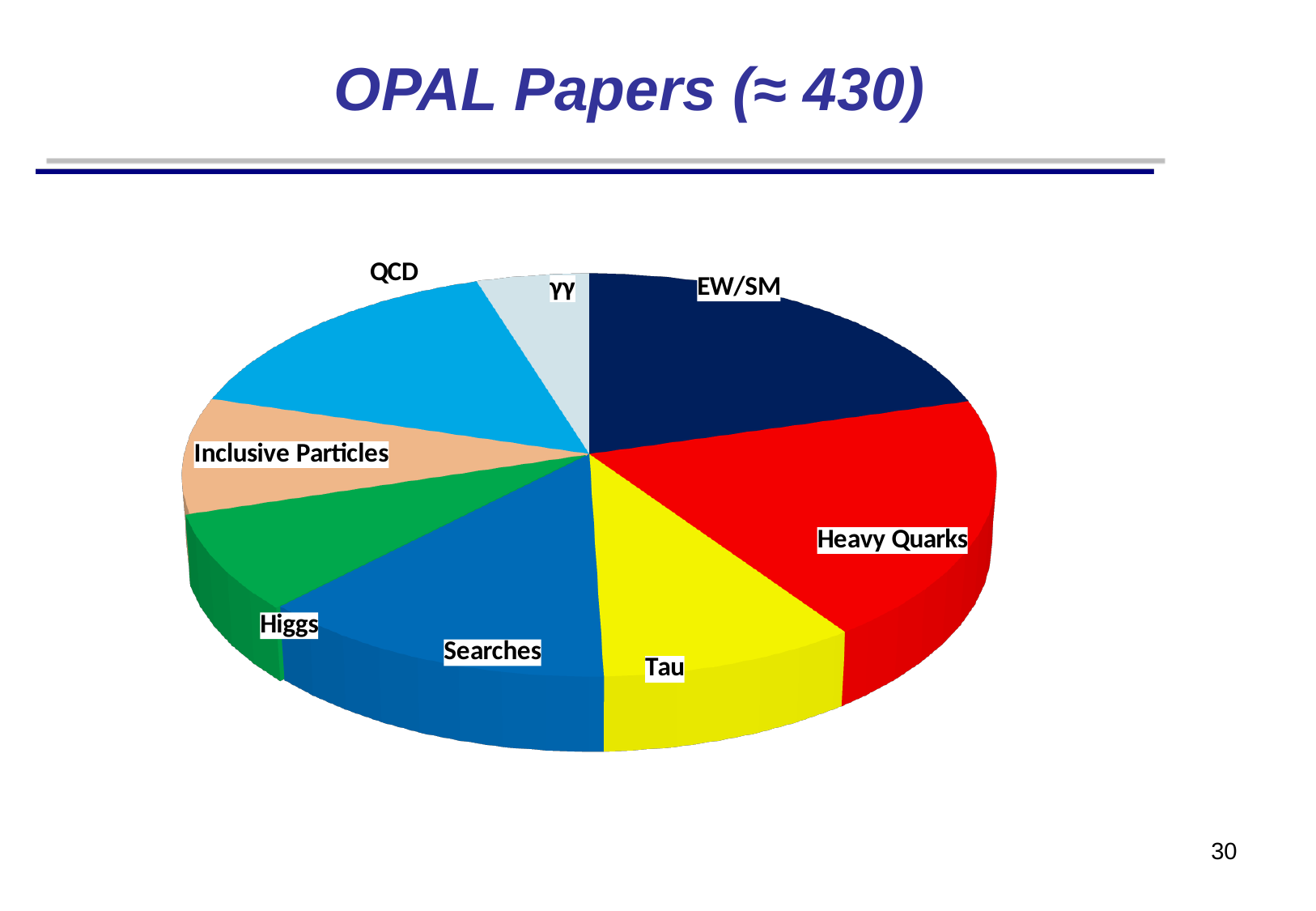
How many slices does the pie chart have? 8 Which slice is larger, Searches or Inclusive Particles? Searches Which slice is larger, Heavy Quarks or Higgs? Heavy Quarks Which category has the smallest slice of the pie? γγ Which slice is larger, Tau or γγ? Tau What colour is the Tau slice of the pie chart? yellow What kind of chart is shown on the slide? pie chart What is the title of the chart on the slide? OPAL Papers (≈ 430)